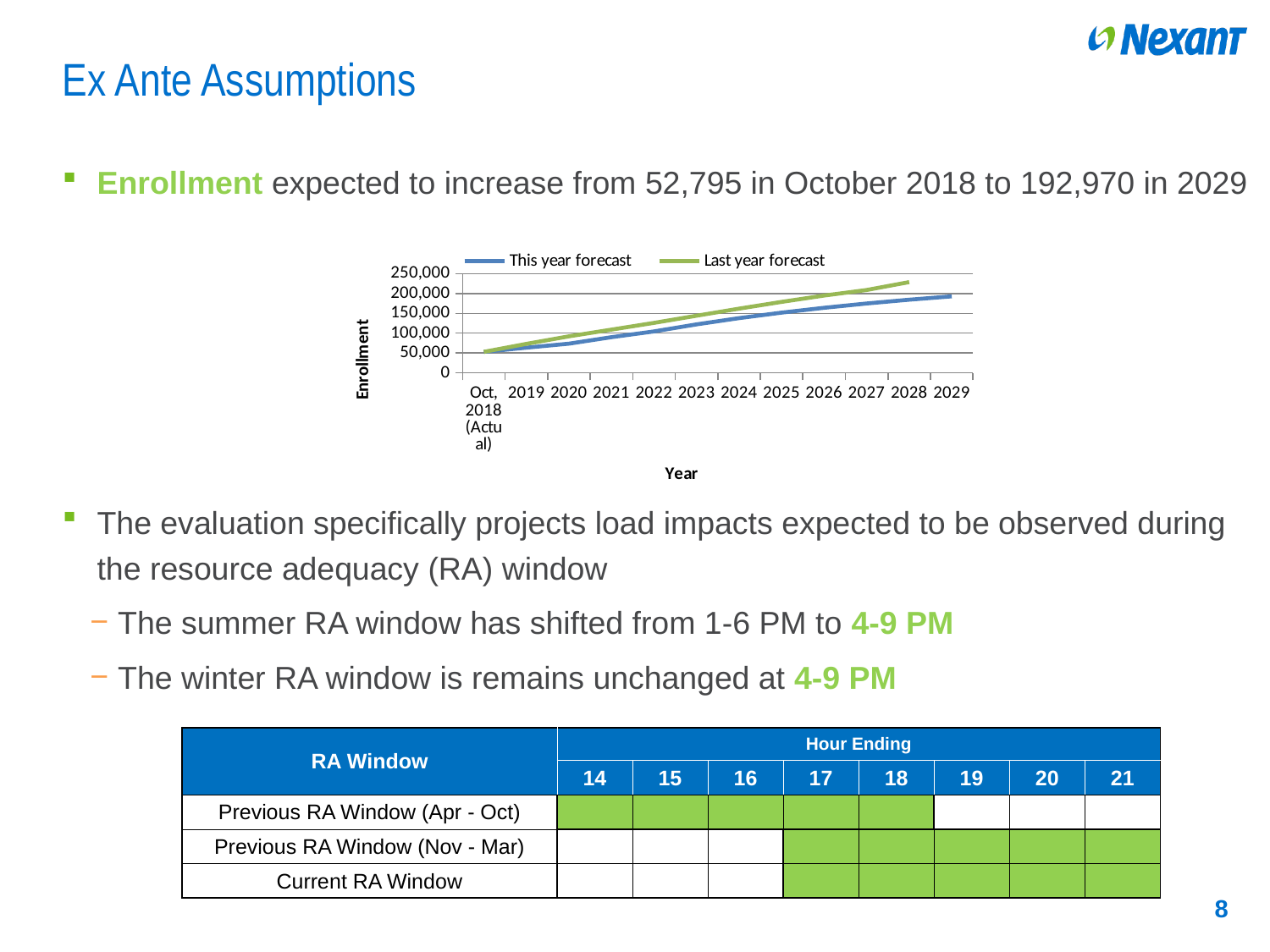
How many series does the chart legend list? 2 Is the This year forecast value for Oct 2018 (Actual) greater or less than 100,000? less In 2025, which series has the higher value: This year forecast or Last year forecast? Last year forecast Which x-axis point has the lowest value for the This year forecast series? Oct, 2018 (Actual) Is the Last year forecast value for 2028 greater or less than 200,000? greater What kind of chart is shown on the slide? line chart What is the title of the chart's vertical axis? Enrollment Is the This year forecast value for 2029 greater or less than 150,000? greater Do the enrollment forecast values rise or fall from Oct 2018 to 2029? rise What are the two series named in the chart legend? This year forecast and Last year forecast How many points are plotted along the x axis of the chart? 12 Which x-axis point has the highest value for the This year forecast series? 2029